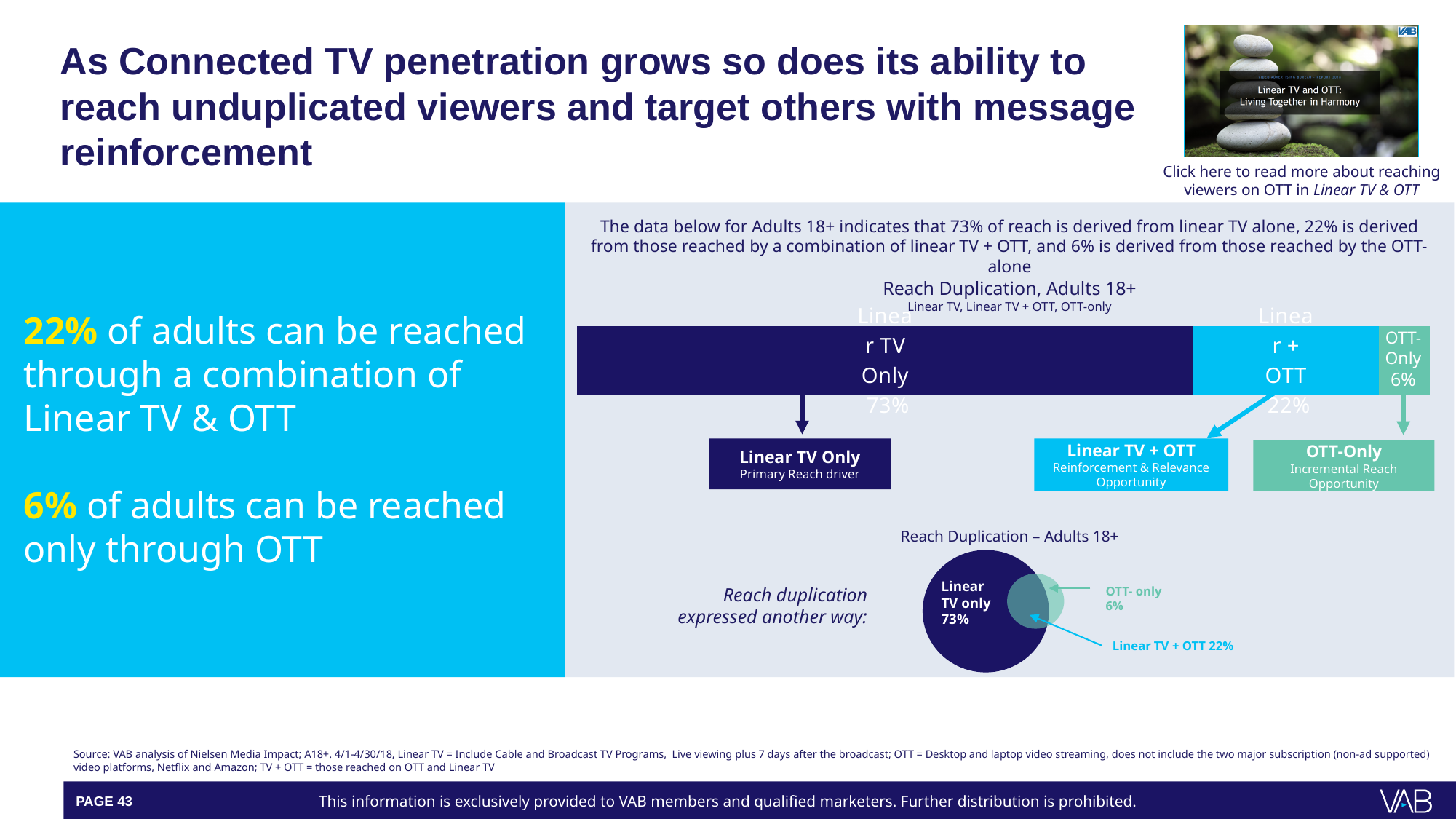
How many segments does the 'Reach Duplication, Adults 18+' bar chart show? 3 In the 'Reach Duplication, Adults 18+' bar chart, which is larger: Linear + OTT or OTT-Only? Linear + OTT What kind of chart is the 'Reach Duplication, Adults 18+' chart? Stacked bar chart In the 'Reach Duplication, Adults 18+' bar chart, what is the value for OTT-Only? 6% In the 'Reach Duplication, Adults 18+' bar chart, which segment has the lowest value? OTT-Only In the 'Reach Duplication, Adults 18+' bar chart, which segment has the highest value? Linear TV Only What is the title of the stacked bar chart on the slide? Reach Duplication, Adults 18+ In the 'Reach Duplication, Adults 18+' bar chart, what is the value for Linear + OTT? 22% In the 'Reach Duplication, Adults 18+' bar chart, what is the value for Linear TV Only? 73% What subtitle appears under the title of the 'Reach Duplication, Adults 18+' bar chart? Linear TV, Linear TV + OTT, OTT-only In the 'Reach Duplication, Adults 18+' bar chart, what is the difference between the Linear TV Only value and the Linear + OTT value? 51% In the 'Reach Duplication, Adults 18+' bar chart, what is the difference between the Linear + OTT value and the OTT-Only value? 16%